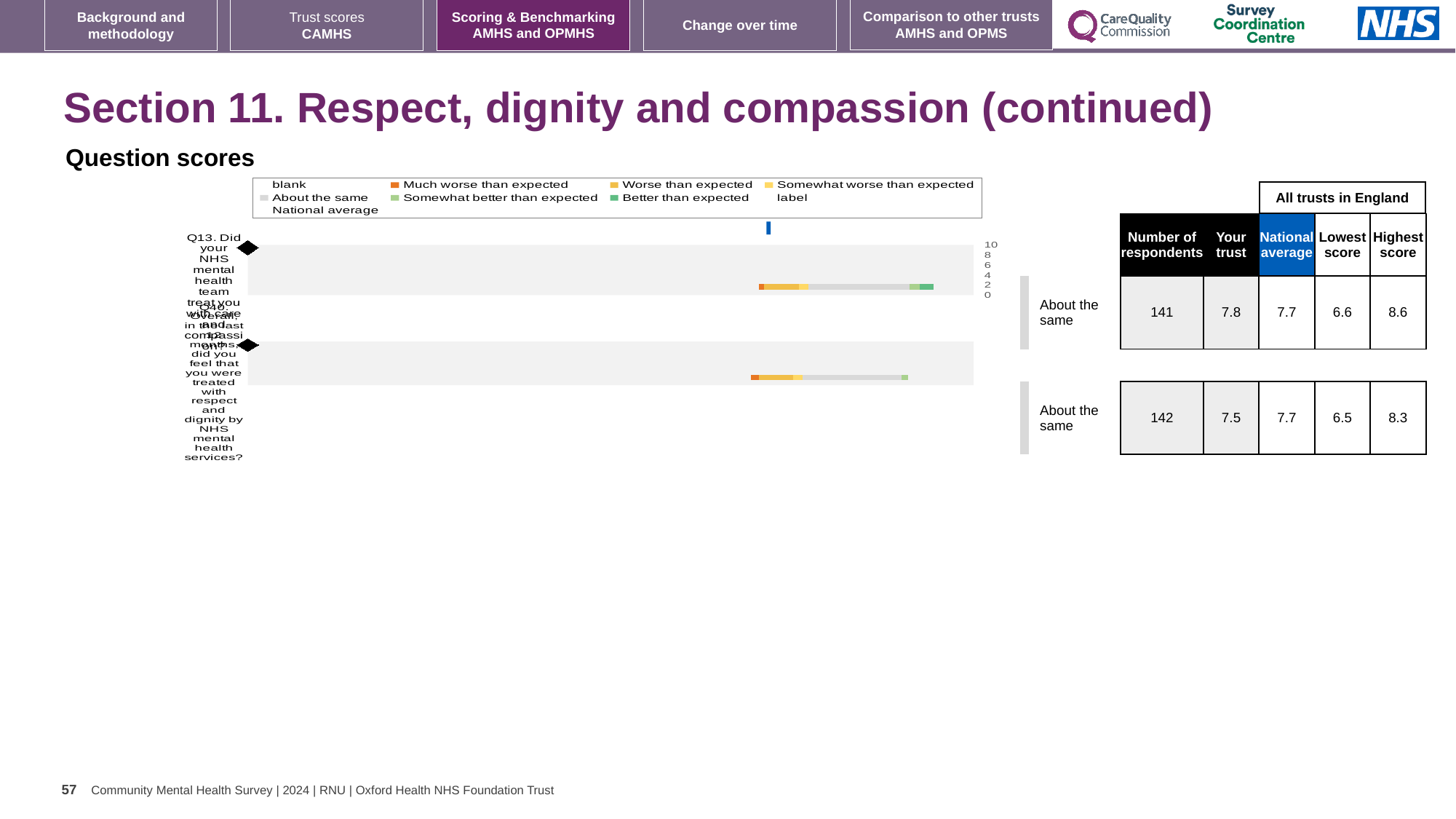
What is the lowest score among all trusts in England for Q10? 6.5 Which question has the higher 'Your trust' score, Q13 or Q10? Q13 For Q10, is the 'Your trust' score higher or lower than the national average? lower What benchmark category is shown for Q13 in the 'Question scores' chart? About the same What is the national average score for Q13? 7.7 What kind of chart is shown under 'Question scores'? bar chart By how much does the 'Your trust' score for Q13 exceed the national average? 0.1 How many survey questions are plotted in the 'Question scores' chart? 2 What is the highest score among all trusts in England for Q13? 8.6 What is the difference between the highest and lowest scores for Q13? 2.0 What is the 'Your trust' score for Q13 (care and compassion)? 7.8 How many respondents answered Q10 (treated with respect and dignity)? 142